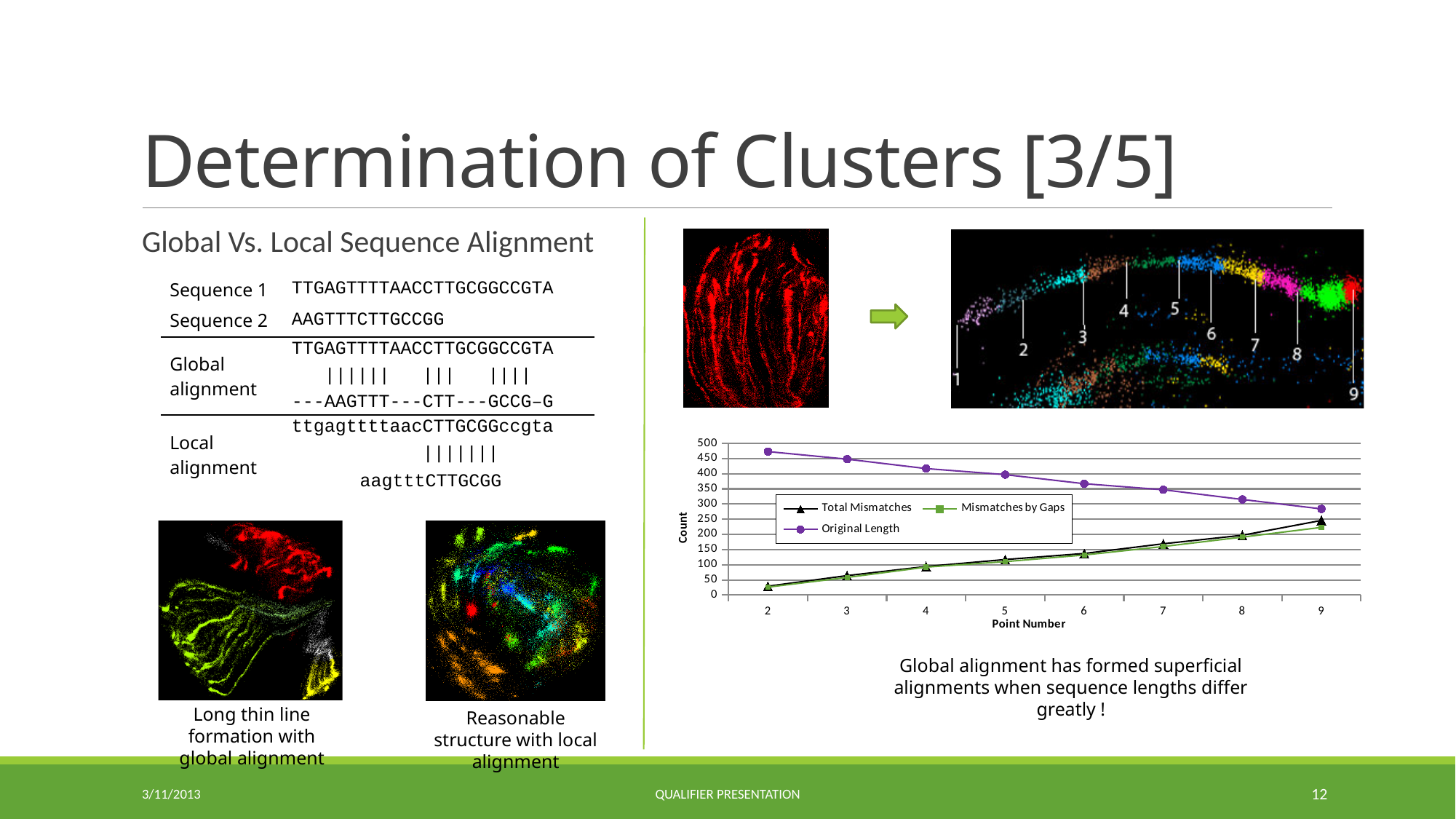
At which point number is Original Length lowest? 9 What is the title of the x axis of the chart? Point Number At which point number is Original Length highest? 2 Is the Total Mismatches value at point number 2 greater or less than 50? less At point number 2, which is larger: Original Length or Total Mismatches? Original Length How many series does the chart legend list? 3 Is the Original Length value at point number 2 greater or less than 450? greater What kind of chart is shown on the slide? line chart At which point number is Total Mismatches highest? 9 Does the Total Mismatches series rise or fall as the point number increases? rise Does the Original Length series rise or fall as the point number increases? fall How many point numbers are plotted along the x axis of the chart? 8